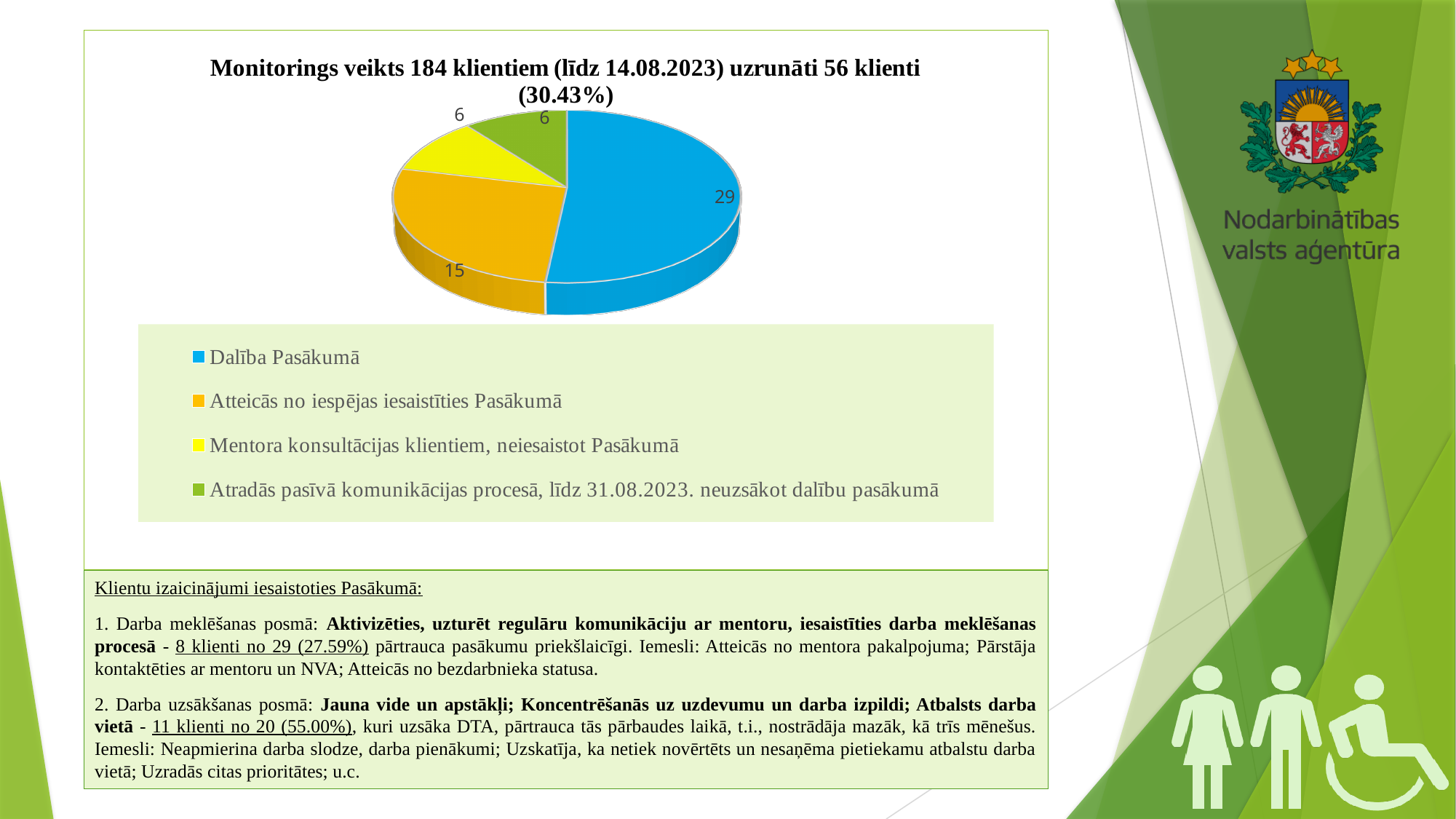
Which category has the largest slice of the pie? Dalība Pasākumā What is the value for "Atteicās no iespējas iesaistīties Pasākumā"? 15 What is the difference between the "Dalība Pasākumā" value and the "Atteicās no iespējas iesaistīties Pasākumā" value? 14 What kind of chart is shown on the slide? pie chart What is the value for "Mentora konsultācijas klientiem, neiesaistot Pasākumā"? 6 Which is larger: "Atteicās no iespējas iesaistīties Pasākumā" or "Mentora konsultācijas klientiem, neiesaistot Pasākumā"? Atteicās no iespējas iesaistīties Pasākumā How many categories does the pie chart have? 4 How many clients are in the "Dalība Pasākumā" slice? 29 What share of the pie does "Dalība Pasākumā" represent? 51.79% What is the total of all slices in the pie chart? 56 Which colour represents "Dalība Pasākumā" in the legend? blue What is the difference between the "Atteicās no iespējas iesaistīties Pasākumā" value and the "Atradās pasīvā komunikācijas procesā" value? 9